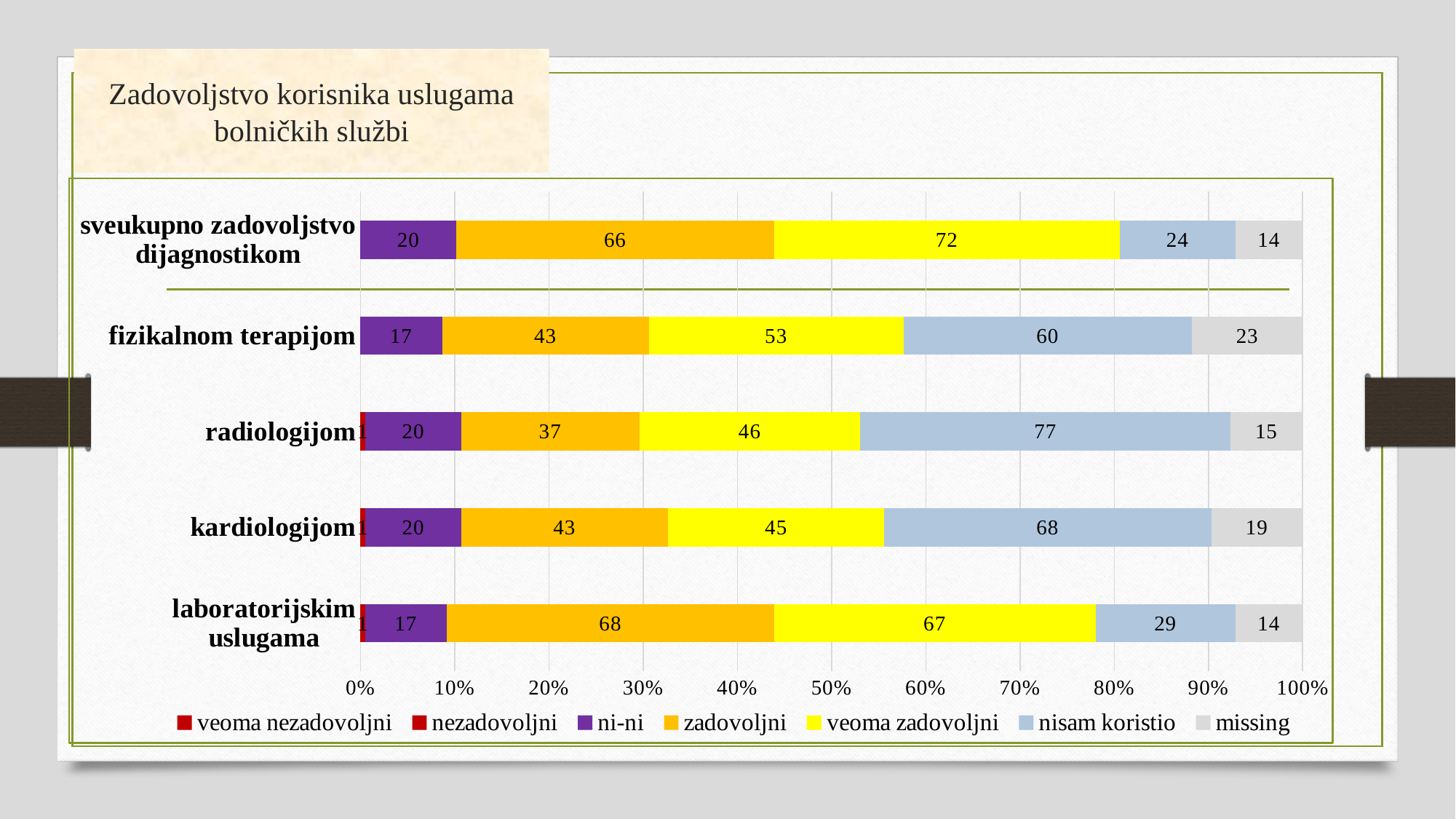
Which category has the highest value for 'zadovoljni'? laboratorijskim uslugama What is the value for 'missing' in the 'kardiologijom' bar? 19 What is the value for 'nisam koristio' in the 'radiologijom' bar? 77 What is the total of the labelled values in the 'sveukupno zadovoljstvo dijagnostikom' bar? 196 Which has a larger 'zadovoljni' value: 'fizikalnom terapijom' or 'radiologijom'? fizikalnom terapijom What kind of chart is shown on the slide? stacked bar chart How many categories are shown on the vertical axis of the chart? 5 What is the value for 'zadovoljni' in the 'laboratorijskim uslugama' bar? 68 How many series does the legend list? 7 What is the value for 'veoma zadovoljni' in the 'fizikalnom terapijom' bar? 53 Which category has the highest value for 'nisam koristio'? radiologijom What is the difference between the 'nisam koristio' values for 'radiologijom' and 'kardiologijom'? 9